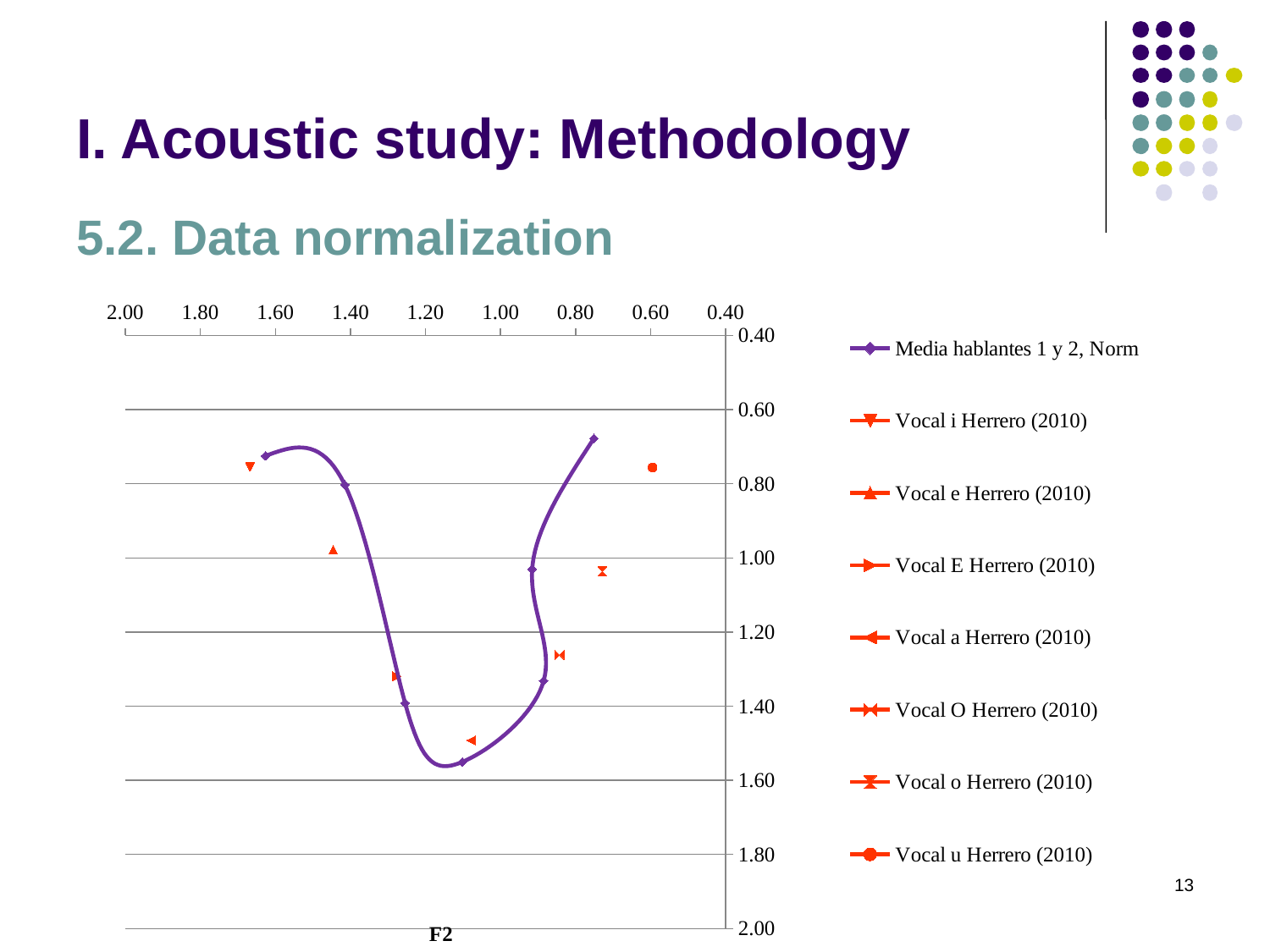
Which series has the lowest vertical-axis value (plotted highest on the chart): 'Vocal a Herrero (2010)' or 'Vocal i Herrero (2010)'? Vocal i Herrero (2010) What is the name of the first series in the legend, drawn as the purple line? Media hablantes 1 y 2, Norm Is the F2 value for 'Vocal i Herrero (2010)' greater or less than 1.40? greater Is the vertical-axis value for 'Vocal a Herrero (2010)' greater or less than 1.20? greater Is the vertical-axis value for 'Vocal o Herrero (2010)' greater or less than 1.20? less What is the label of the horizontal axis? F2 How many series does the legend list? 8 How many data points are plotted on the purple 'Media hablantes 1 y 2, Norm' line? 7 What kind of chart is shown on the slide? line chart (scatter with smoothed line)